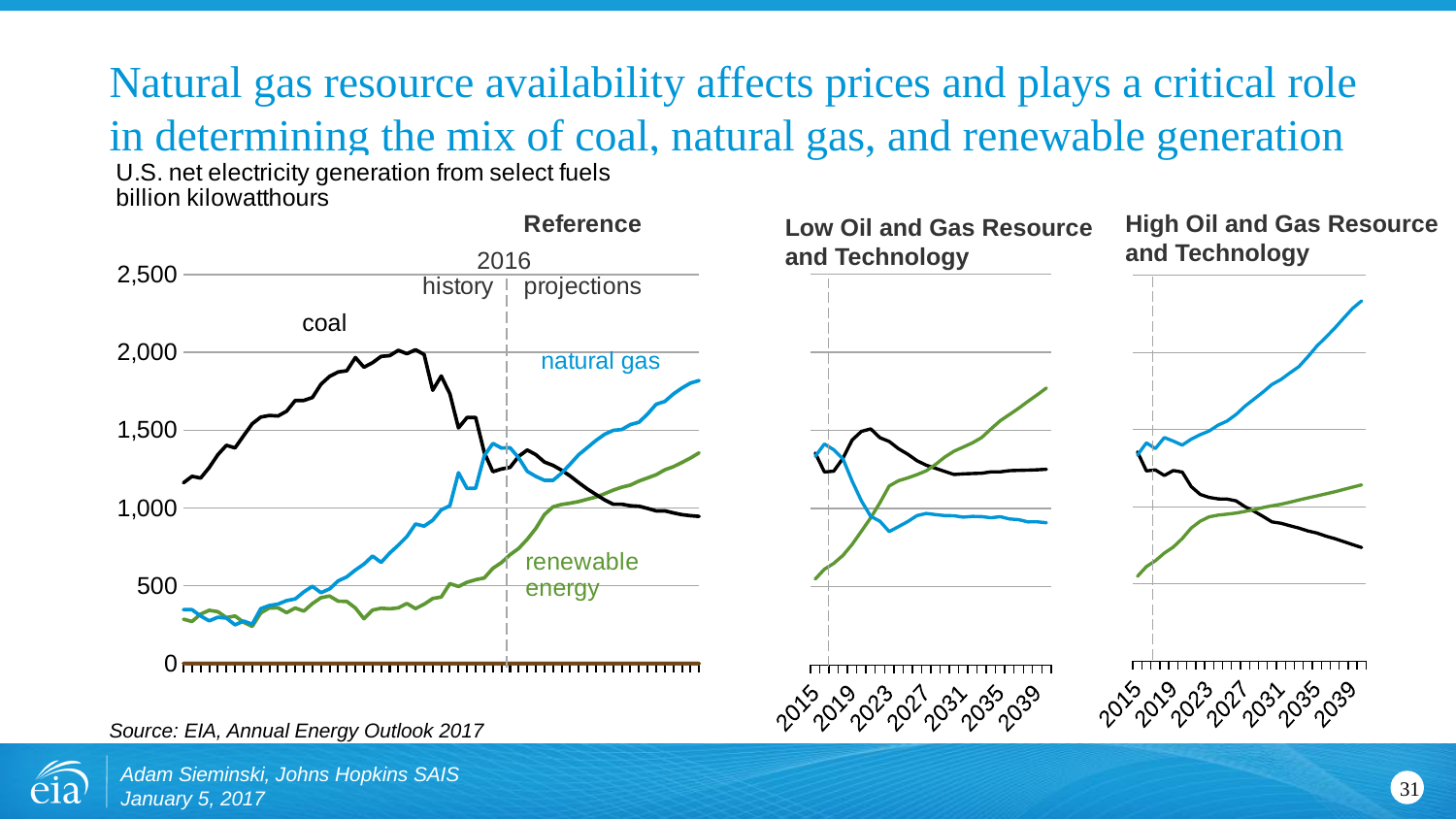
In the Reference chart, does coal generation rise or fall over the projection period after 2016? fall In the Low Oil and Gas Resource and Technology chart, which fuel has the highest generation in 2039? renewable energy In the High Oil and Gas Resource and Technology chart, which fuel has the lowest generation in 2039? coal How many charts are shown on the slide? 3 In the Reference chart, is the value for renewable energy at the start of the history period greater or less than 500? less In the Reference chart, which fuel has the highest generation at the end of the projection period? natural gas In the Reference chart, which year separates history from projections? 2016 How many fuel series are plotted in the Reference chart? 3 What kind of chart is the Reference chart? line chart In the Reference chart, is the value for coal at the end of the projection period greater or less than 1,000? less In the Reference chart, does natural gas generation rise or fall over the projection period after 2016? rise In the Reference chart, is the value for natural gas at the end of the projection period greater or less than 1,500? greater